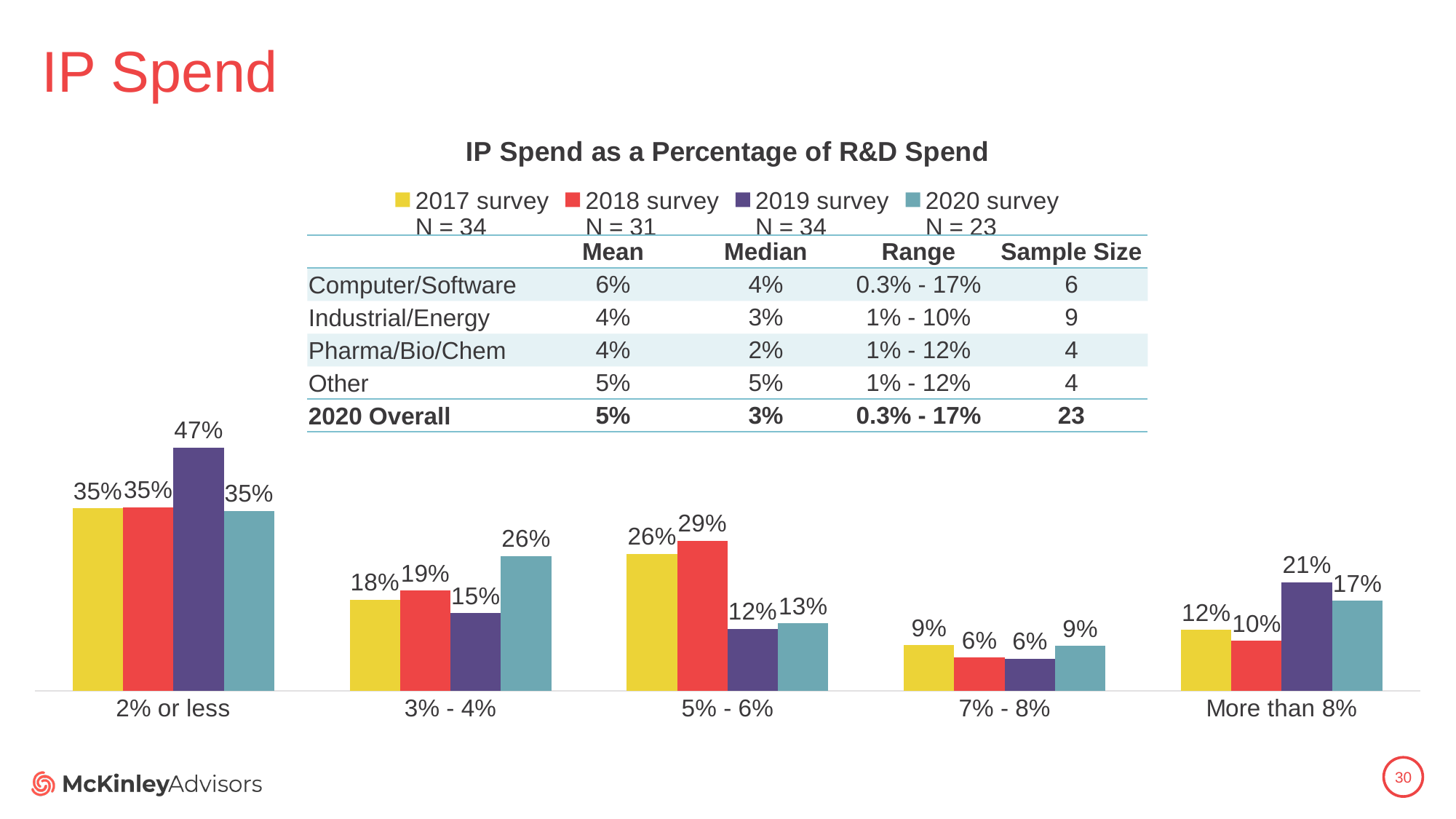
What is the sample size (N) for the 2020 survey shown in the legend? N = 23 What kind of chart is shown on the slide? bar chart In the '5% - 6%' category, which is larger: the 2017 survey value or the 2019 survey value? 2017 survey What is the value for the 2018 survey in the '5% - 6%' category? 29% What is the difference between the 2019 survey and 2018 survey values in the 'More than 8%' category? 11% Which category has the highest value for the 2017 survey? 2% or less How many categories are shown along the x axis of the chart? 5 What is the value for the 2019 survey in the '2% or less' category? 47% What is the value for the 2020 survey in the '3% - 4%' category? 26% How many series does the chart legend list? 4 What is the title of the chart? IP Spend as a Percentage of R&D Spend Which category has the lowest value for the 2020 survey? 7% - 8%